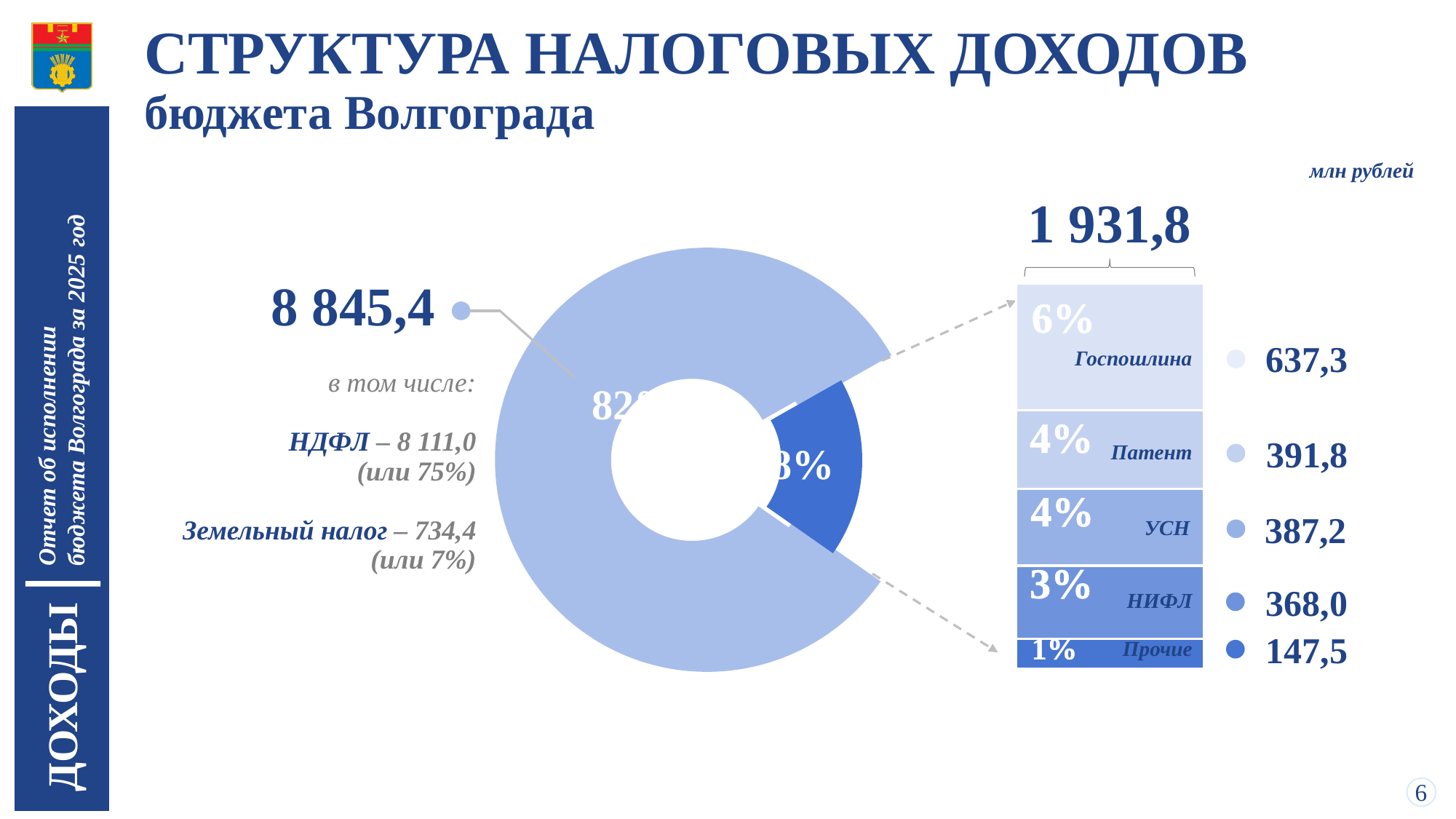
In the stacked bar on the right, what is the value for Патент? 391,8 In the stacked bar on the right, what is the value for Прочие? 147,5 What unit of measurement is stated for the values on the slide? млн рублей In the stacked bar on the right, what is the difference between Госпошлина and Прочие? 489,8 In the stacked bar on the right, which segment has the highest value? Госпошлина How many segments does the stacked bar on the right have? 5 In the stacked bar on the right, what share does Госпошлина represent? 6% What is the total of the stacked bar on the right? 1 931,8 In the stacked bar on the right, what is the value for Госпошлина? 637,3 In the stacked bar on the right, which is larger: Патент or УСН? Патент In the stacked bar on the right, what is the value for НИФЛ? 368,0 In the stacked bar on the right, which segment has the lowest value? Прочие